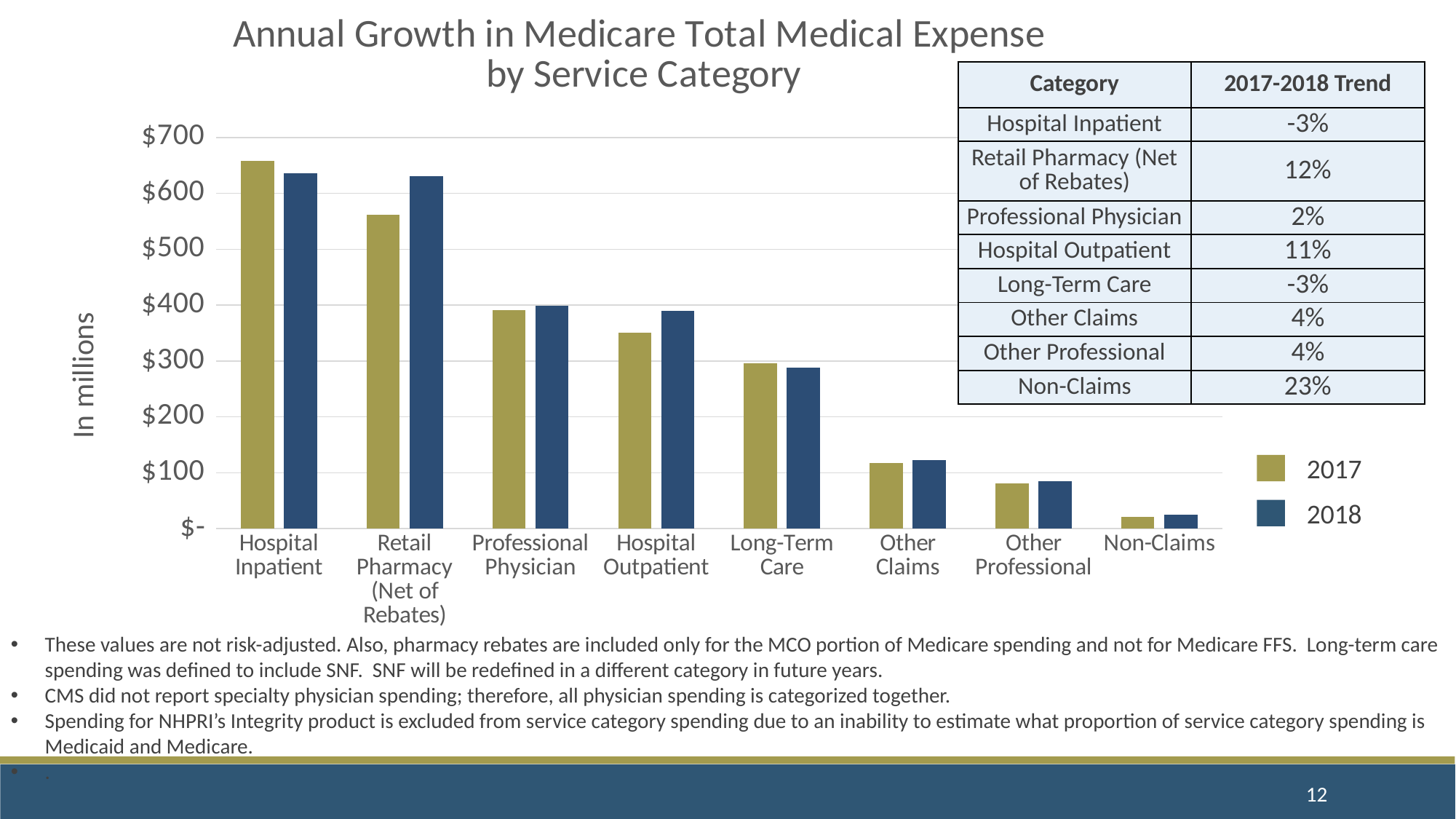
What kind of chart is shown on the slide? bar chart For Retail Pharmacy (Net of Rebates), which year has the larger value, 2017 or 2018? 2018 What is the label on the y axis of the chart? In millions Is the 2017 value for Hospital Outpatient greater or less than $400? less How many service categories are plotted on the x axis of the chart? 8 Which service category has the highest 2017 value in the chart? Hospital Inpatient Which service category has the lowest 2018 value in the chart? Non-Claims Is the 2017 value for Hospital Inpatient greater or less than $600? greater Is the 2017 value for Retail Pharmacy (Net of Rebates) greater or less than $600? less How many series does the chart legend list? 2 For Hospital Inpatient, which year has the larger value, 2017 or 2018? 2017